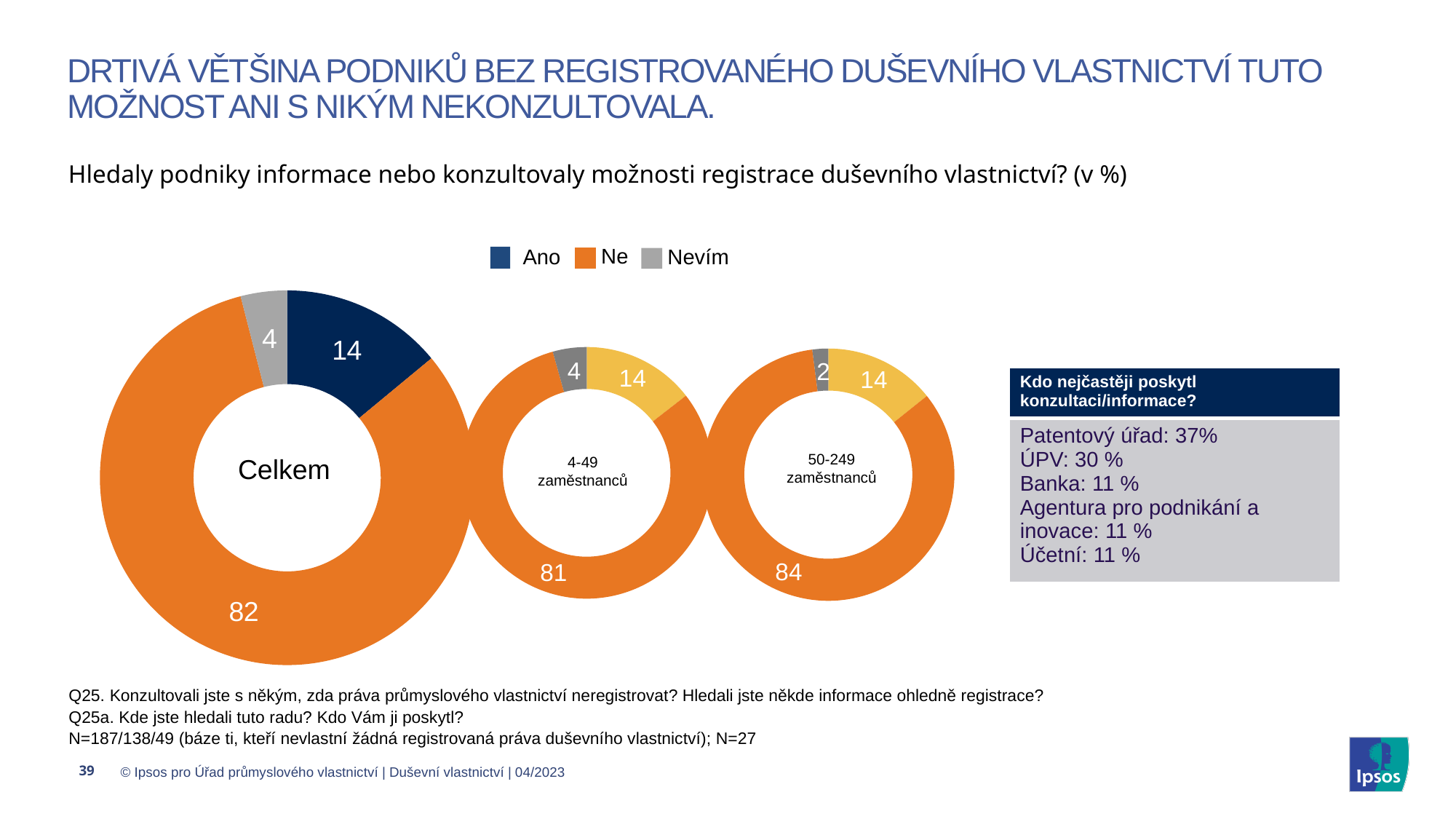
In the 'Celkem' donut chart, which category has the smallest share? Nevím How many entries does the legend list? 3 In the 'Celkem' donut chart, what is the value for 'Nevím'? 4 In the 'Celkem' donut chart, which category has the largest share? Ne In the 'Celkem' donut chart, what is the value for 'Ano'? 14 What is the difference between the 'Ne' value in the '50-249 zaměstnanců' chart and the 'Ne' value in the '4-49 zaměstnanců' chart? 3 In the '4-49 zaměstnanců' donut chart, what is the value for 'Ne'? 81 In the '50-249 zaměstnanců' donut chart, what is the value for 'Nevím'? 2 Which is larger: the 'Nevím' value in the '4-49 zaměstnanců' chart or in the '50-249 zaměstnanců' chart? 4-49 zaměstnanců What kind of chart is used on this slide? Donut (pie) chart In the 'Celkem' donut chart, what is the value for 'Ne'? 82 In the '50-249 zaměstnanců' donut chart, what is the value for 'Ne'? 84